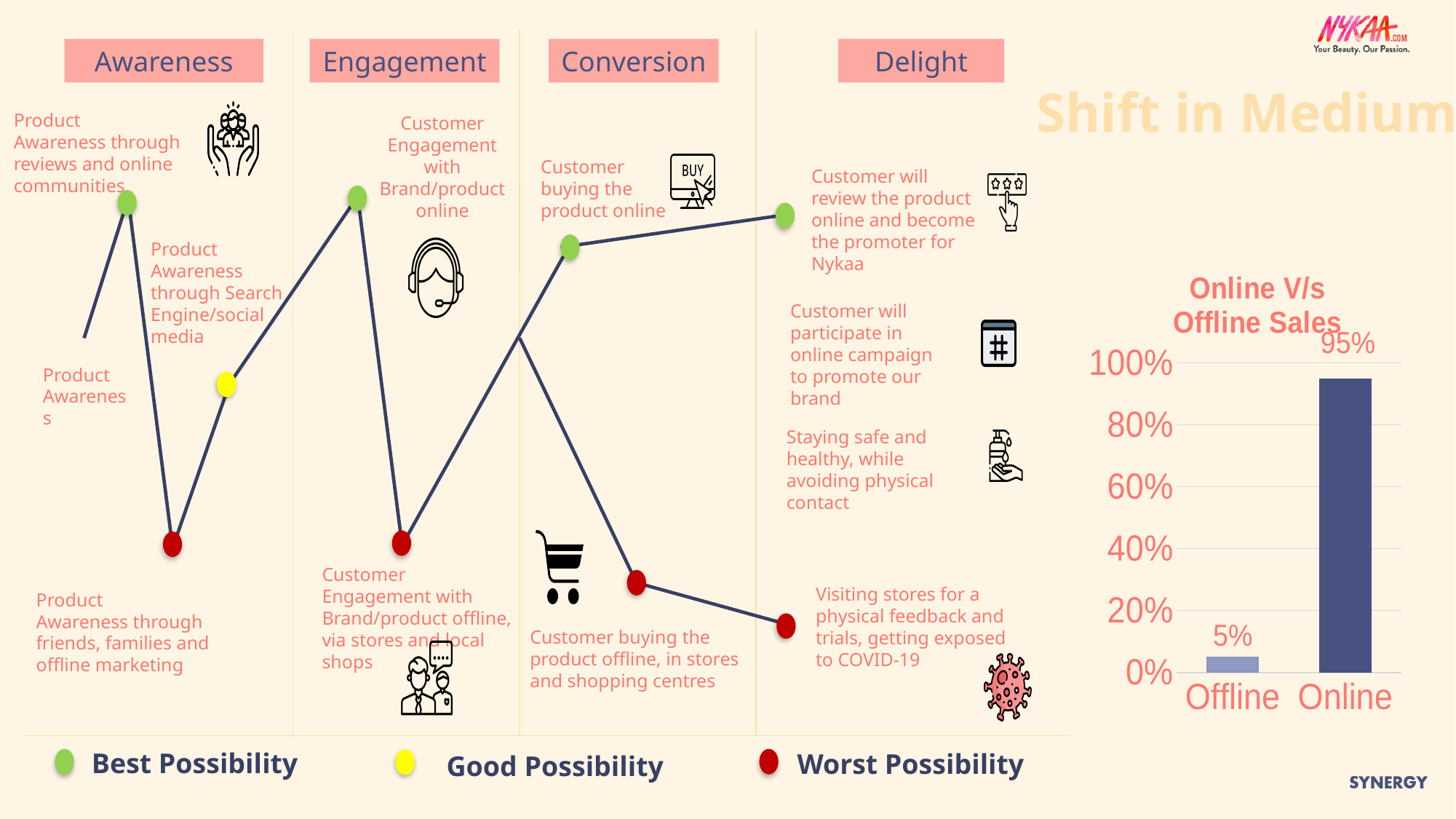
How many categories are shown in the Online V/s Offline Sales chart? 2 In the Online V/s Offline Sales chart, what is the value for Offline? 5% What kind of chart is the Online V/s Offline Sales chart? bar chart In the Online V/s Offline Sales chart, which category has the lowest value? Offline In the Online V/s Offline Sales chart, which is larger, Online or Offline? Online In the Online V/s Offline Sales chart, which category has the highest value? Online In the Online V/s Offline Sales chart, is the value for Offline greater or less than 20%? less In the Online V/s Offline Sales chart, what is the value for Online? 95% In the Online V/s Offline Sales chart, what is the highest value shown on the vertical axis? 100% In the Online V/s Offline Sales chart, is the value for Online greater or less than 80%? greater In the Online V/s Offline Sales chart, what is the difference between the Online and Offline values? 90% What is the title of the bar chart on the right of the slide? Online V/s Offline Sales